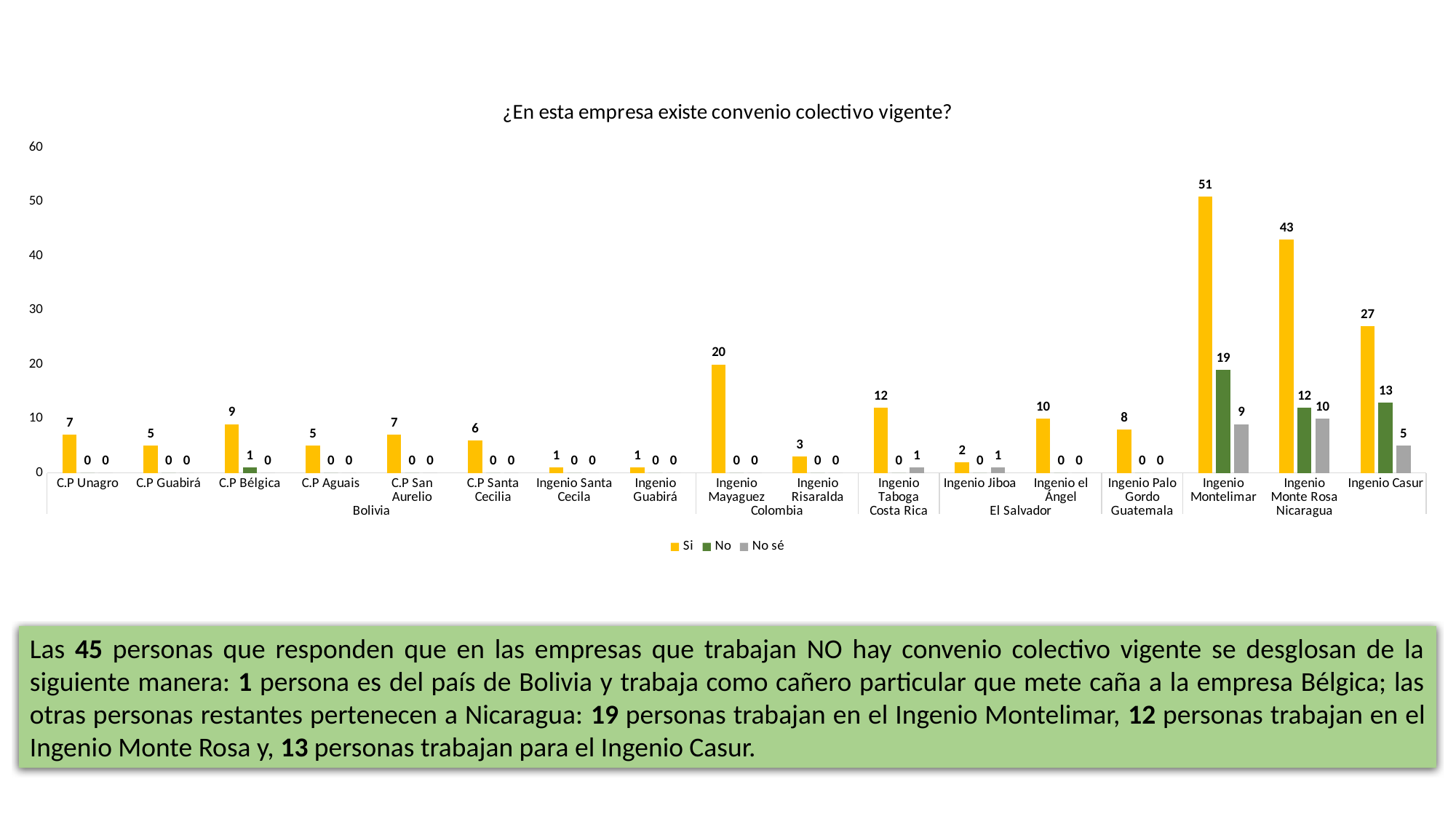
What is the 'Si' value for Ingenio Montelimar? 51 Which company has the highest 'No' value? Ingenio Montelimar What kind of chart is shown on the slide? bar chart Which is larger, the 'Si' value for Ingenio Mayaguez or the 'Si' value for Ingenio Casur? Ingenio Casur What is the 'No' value for Ingenio Monte Rosa? 12 Which company has the highest 'Si' value? Ingenio Montelimar What colour represents the 'No' series in the chart? green What is the 'No sé' value for Ingenio Taboga? 1 Is the 'Si' value for Ingenio Monte Rosa greater or less than 40? greater How many series does the legend list? 3 What is the title of the chart? ¿En esta empresa existe convenio colectivo vigente? What is the difference between the 'Si' values for Ingenio Montelimar and Ingenio Monte Rosa? 8